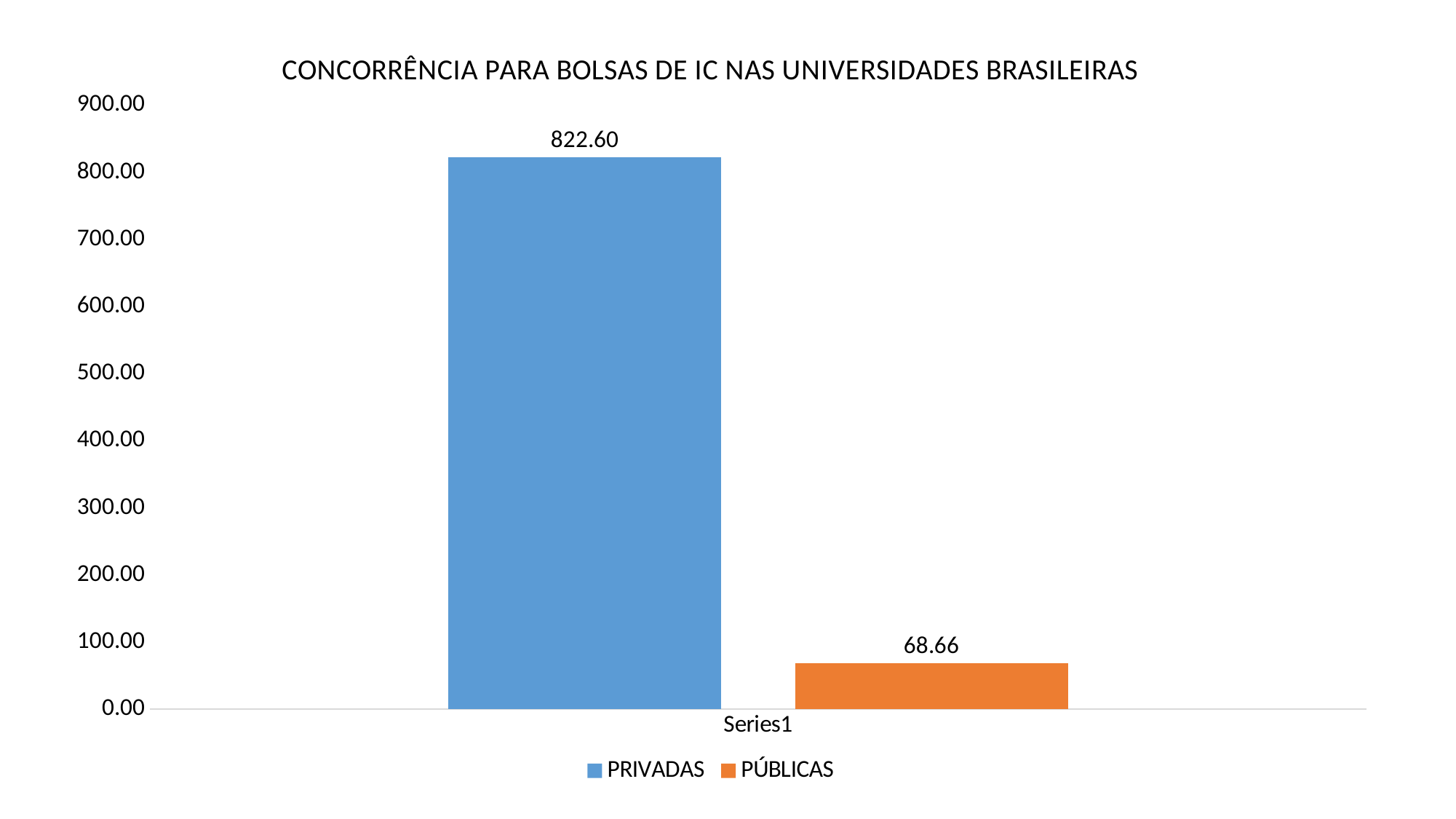
What is the difference between the PRIVADAS and PÚBLICAS values? 753.94 What kind of chart is shown on the slide? bar chart Is the value for PÚBLICAS greater or less than 100.00? less Which is larger, the value for PRIVADAS or the value for PÚBLICAS? PRIVADAS What is the value for PRIVADAS? 822.60 Is the value for PRIVADAS greater or less than 800.00? greater What colour is the PÚBLICAS bar? orange What is the value for PÚBLICAS? 68.66 How many series does the legend list? 2 What is the title of the chart? CONCORRÊNCIA PARA BOLSAS DE IC NAS UNIVERSIDADES BRASILEIRAS Which series has the lowest value? PÚBLICAS Which series has the highest value? PRIVADAS